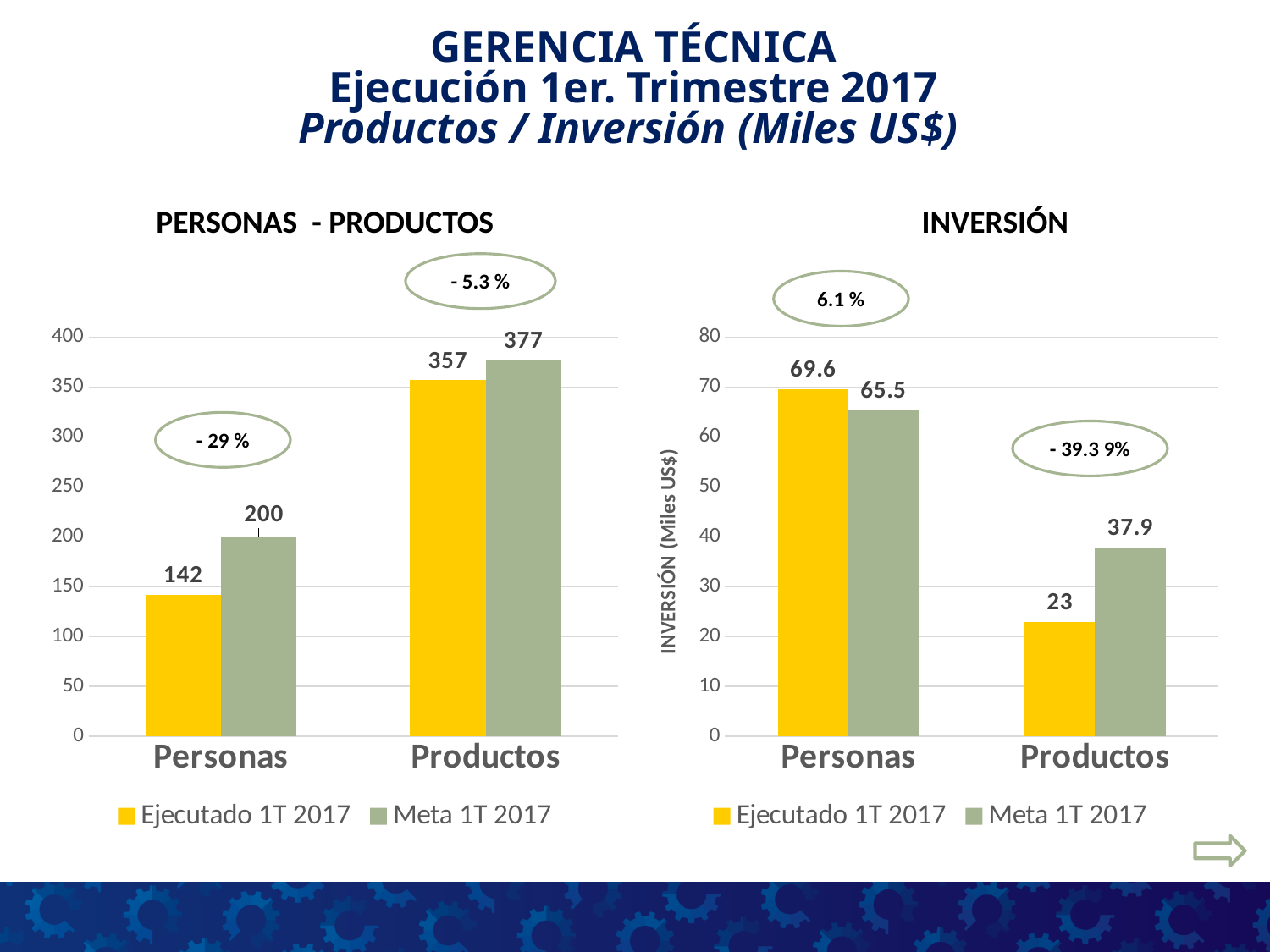
In the INVERSIÓN chart, what is the Ejecutado 1T 2017 value for Personas? 69.6 How many series does the legend of the INVERSIÓN chart list? 2 What kind of chart is the PERSONAS - PRODUCTOS chart? Bar chart In the PERSONAS - PRODUCTOS chart, what is the difference between the Meta 1T 2017 and Ejecutado 1T 2017 values for Personas? 58 In the PERSONAS - PRODUCTOS chart, what is the Ejecutado 1T 2017 value for Personas? 142 In the PERSONAS - PRODUCTOS chart, which bar is the highest? Meta 1T 2017 for Productos In the INVERSIÓN chart, what is the y-axis title? INVERSIÓN (Miles US$) In the INVERSIÓN chart, what is the difference between the Meta 1T 2017 and Ejecutado 1T 2017 values for Productos? 14.9 In the INVERSIÓN chart, which is larger for Personas: Ejecutado 1T 2017 or Meta 1T 2017? Ejecutado 1T 2017 In the INVERSIÓN chart, which bar is the lowest? Ejecutado 1T 2017 for Productos In the PERSONAS - PRODUCTOS chart, what is the Meta 1T 2017 value for Productos? 377 In the INVERSIÓN chart, what is the Meta 1T 2017 value for Productos? 37.9